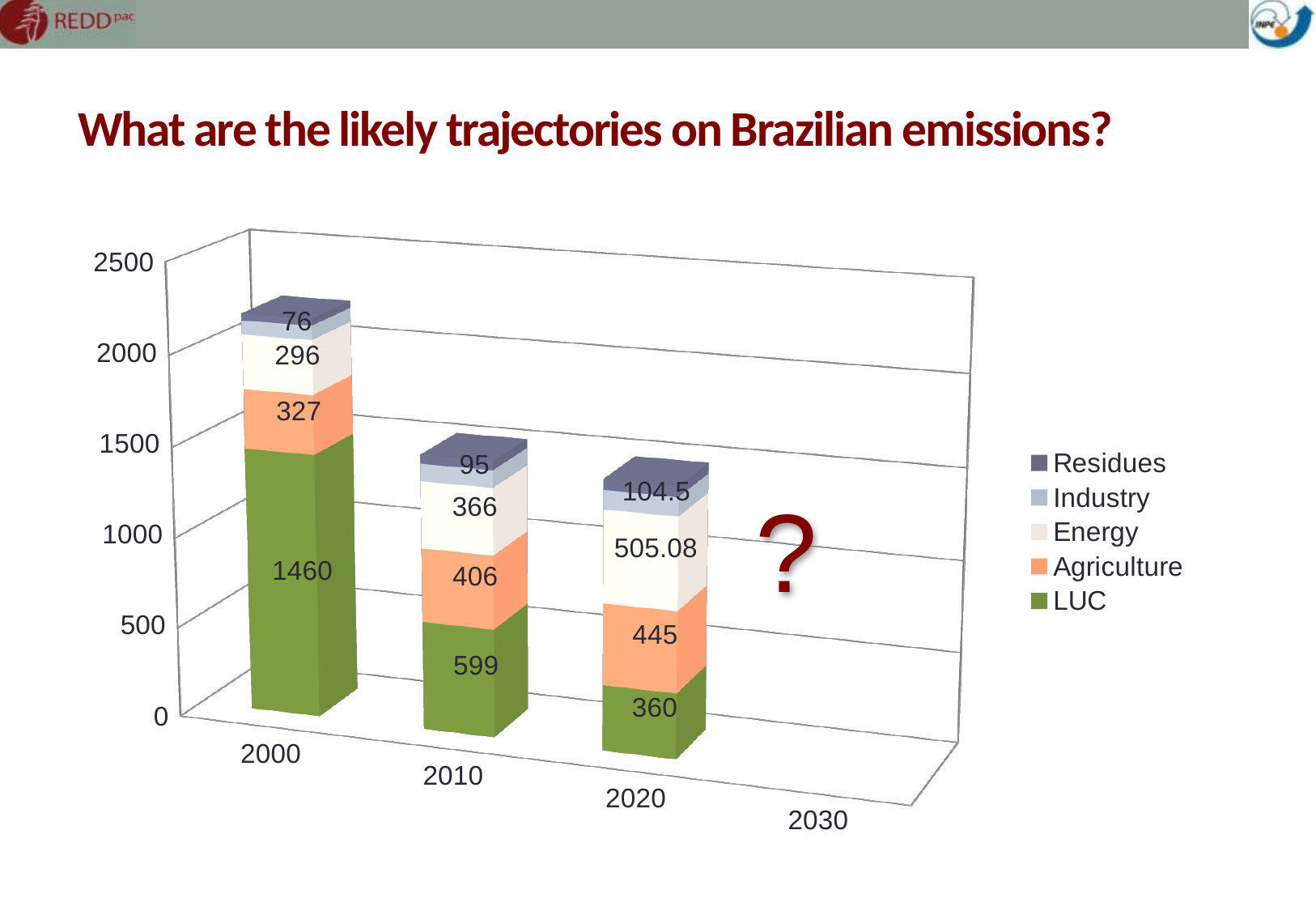
What is the difference between the Agriculture values for 2020 and 2000? 118 In which year is the LUC value highest? 2000 Do the LUC values rise or fall from 2000 to 2020? fall What kind of chart is shown on the slide? stacked bar chart What is the Energy value for 2020? 505.08 What is the difference between the LUC values for 2000 and 2010? 861 In 2010, which is larger: the Energy value or the Agriculture value? Agriculture How many series does the legend list? 5 What is the LUC value for 2020? 360 What is the LUC value for 2000? 1460 What is the Agriculture value for 2010? 406 In which year is the LUC value lowest? 2020